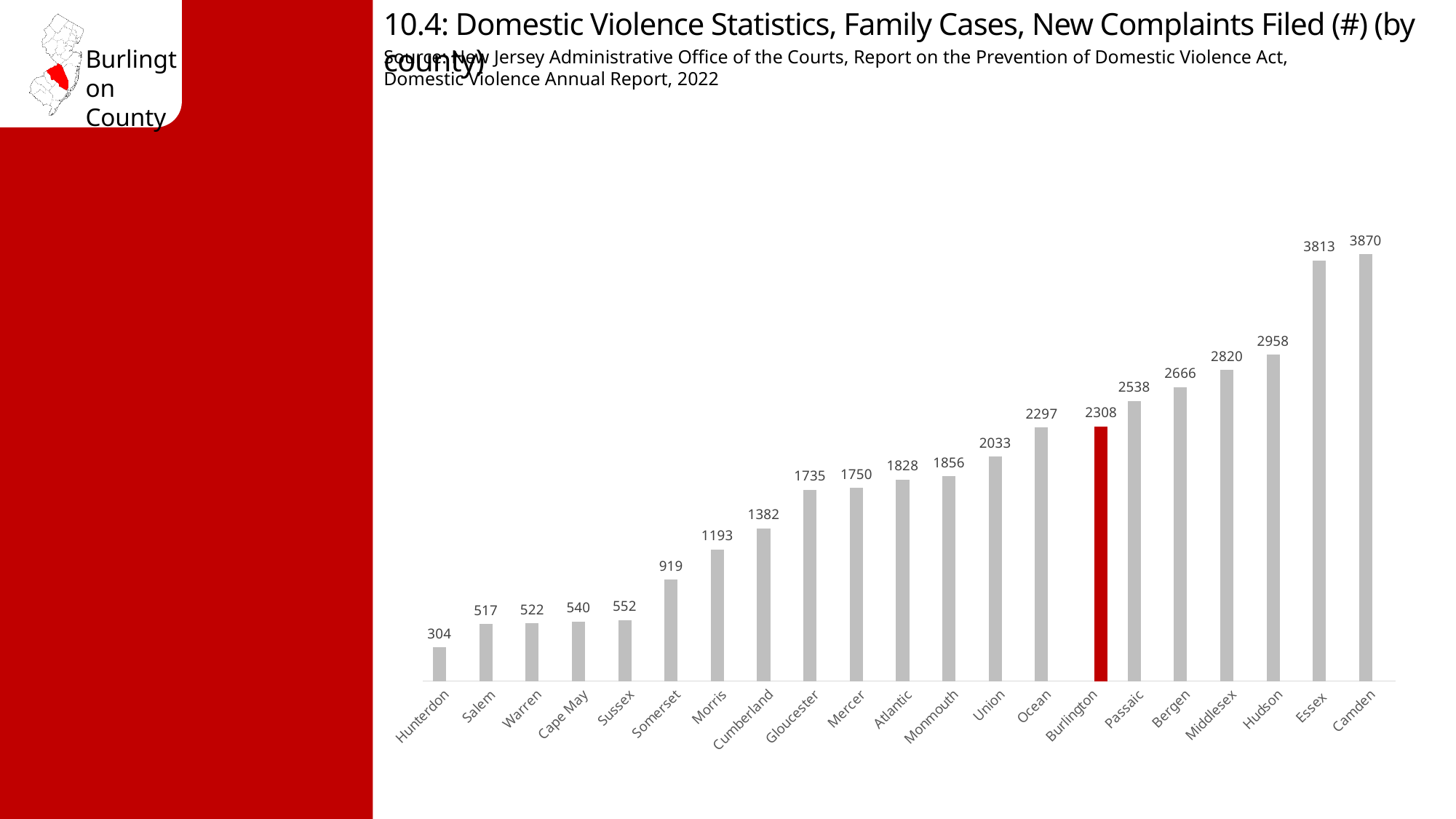
Do the values rise or fall from left to right along the x axis? Rise What is the value for Camden? 3870 What is the difference between the values for Camden and Essex? 57 What kind of chart is shown on the slide? Bar chart Which county's bar is highlighted in red? Burlington What is the value for Somerset? 919 Which county has the highest number of new complaints filed? Camden Which is larger, the value for Passaic or the value for Union? Passaic Which county has the lowest number of new complaints filed? Hunterdon How many counties are shown in the chart? 21 What is the difference between the values for Burlington and Hunterdon? 2004 What is the value for Burlington? 2308